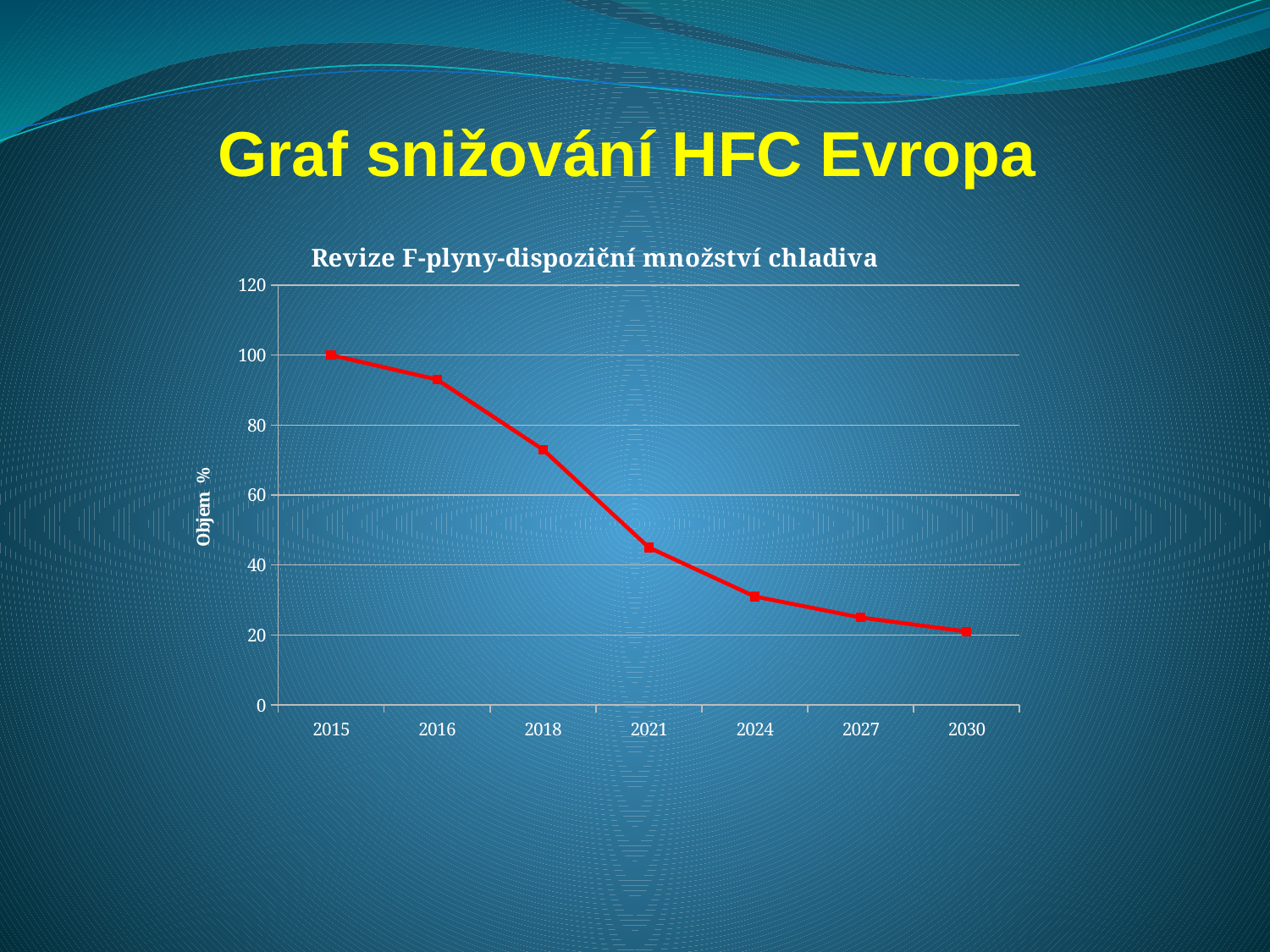
Which year has the highest value? 2015 How many years are plotted on the x axis? 7 What is the label of the vertical axis? Objem % Is the value for 2024 greater or less than 40? less Is the value for 2018 greater or less than 60? greater Do the values rise or fall from 2015 to 2030? fall Which is larger, the value for 2016 or the value for 2027? 2016 What is the value for 2015? 100 Is the value for 2021 greater or less than 60? less What is the title of the chart? Revize F-plyny-dispoziční množství chladiva Which year has the lowest value? 2030 What kind of chart is shown on the slide? line chart